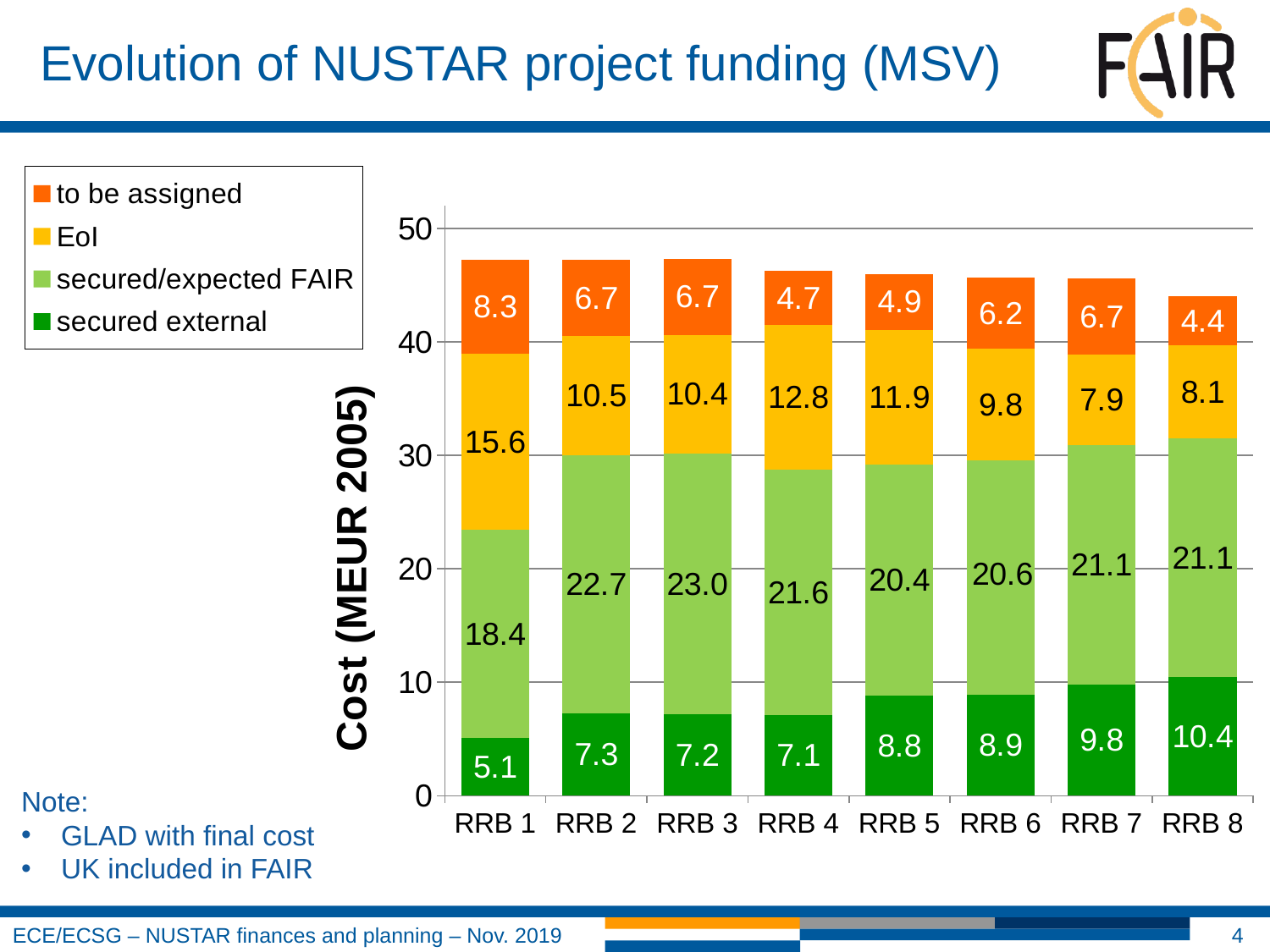
What is the EoI value for RRB 4? 12.8 What kind of chart is shown on the slide? Stacked bar chart How many RRB categories are shown on the x axis? 8 Which RRB has the highest secured external value? RRB 8 What is the total cost for RRB 2 (sum of all four segments)? 47.2 What is the secured external value for RRB 1? 5.1 Which RRB has the lowest EoI value? RRB 7 What is the secured/expected FAIR value for RRB 3? 23.0 Which is larger, the 'to be assigned' value for RRB 1 or for RRB 6? RRB 1 How many series does the legend list? 4 What is the 'to be assigned' value for RRB 8? 4.4 What is the difference between the secured external values for RRB 8 and RRB 1? 5.3